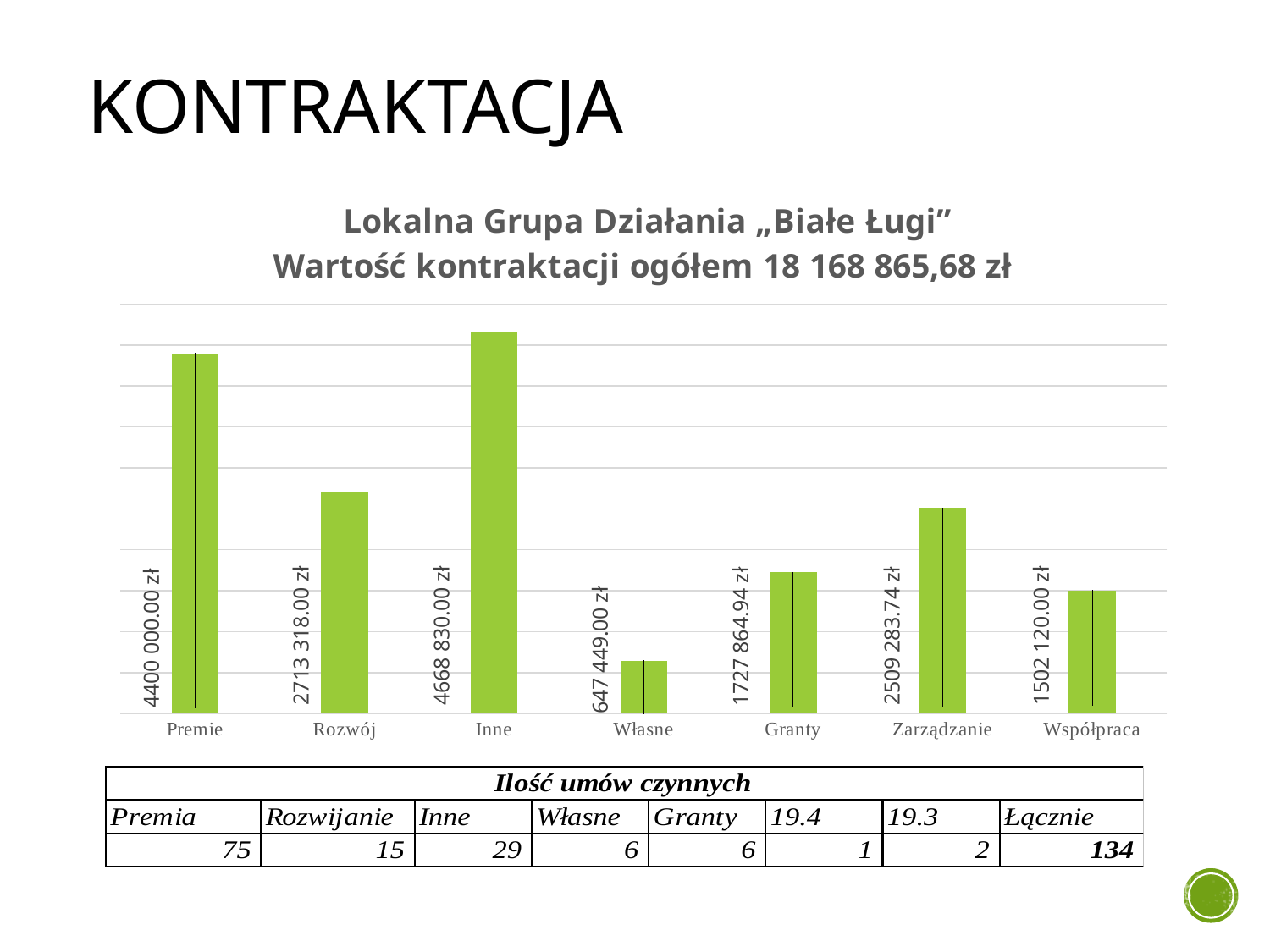
What is the difference between the values for Zarządzanie and Współpraca? 1007 163.74 zł Which category has the highest value? Inne What is the value for Zarządzanie? 2509 283.74 zł What kind of chart is shown on the slide? Bar chart How many categories are shown in the chart? 7 What total contract value is stated in the chart title? 18 168 865,68 zł What is the value for Granty? 1727 864.94 zł Which category has the lowest value? Własne Which is larger, the value for Rozwój or the value for Zarządzanie? Rozwój What is the value for Własne? 647 449.00 zł What is the value for Premie? 4400 000.00 zł What is the difference between the values for Inne and Premie? 268 830.00 zł